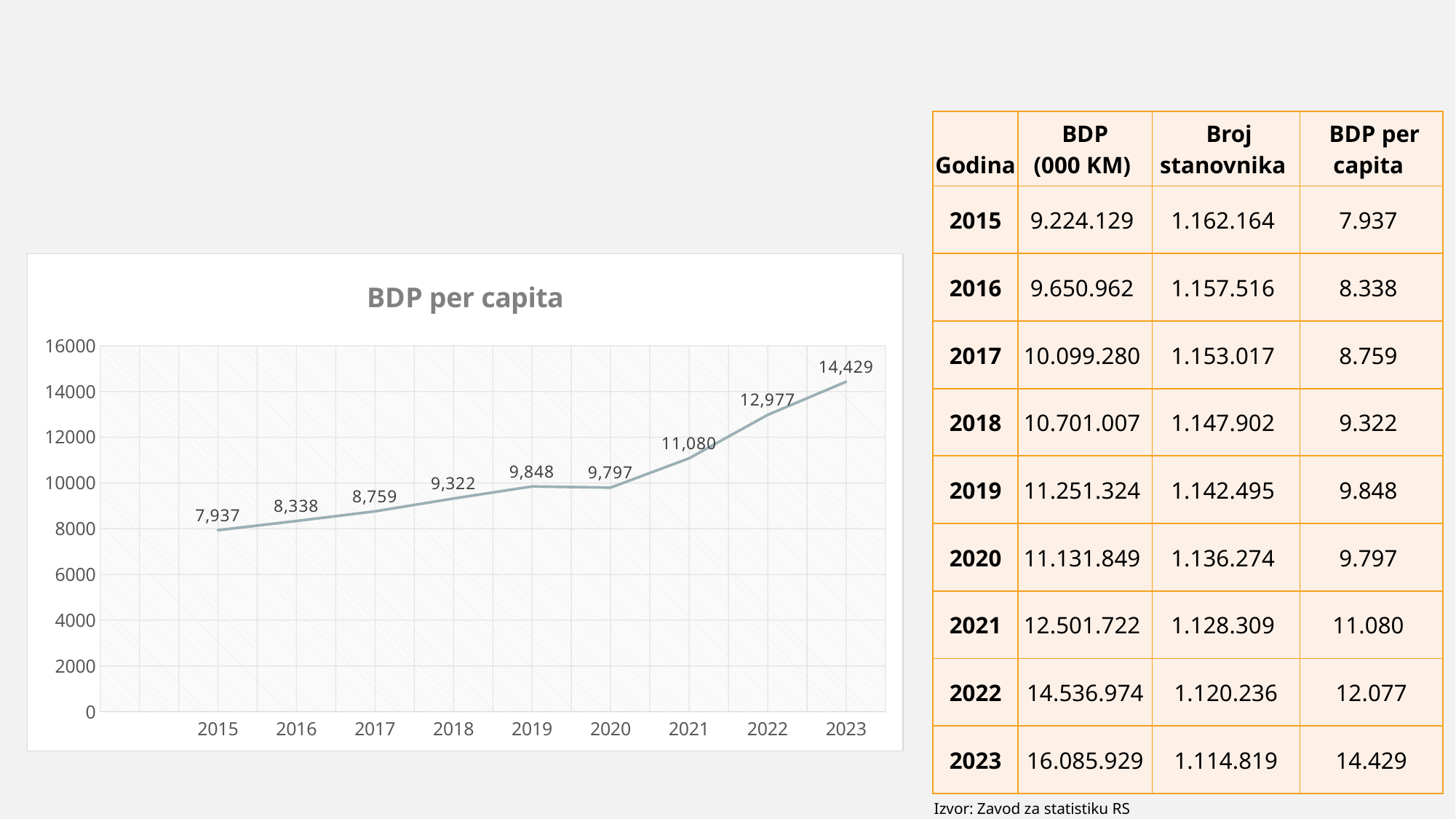
Which year has the lowest BDP per capita on the chart? 2015 What is the difference between the BDP per capita values for 2023 and 2022 on the chart? 1,452 Is the BDP per capita value for 2021 greater or less than 10000? greater How many years are plotted on the BDP per capita chart? 9 What is the BDP per capita value for 2015 on the chart? 7,937 Which is larger on the chart, the BDP per capita for 2019 or for 2020? 2019 Does the BDP per capita generally rise or fall from 2015 to 2023? rise What is the title of the chart? BDP per capita What type of chart is used to show BDP per capita? line chart What is the BDP per capita value for 2023 on the chart? 14,429 Which year has the highest BDP per capita on the chart? 2023 What is the BDP per capita value for 2020 on the chart? 9,797